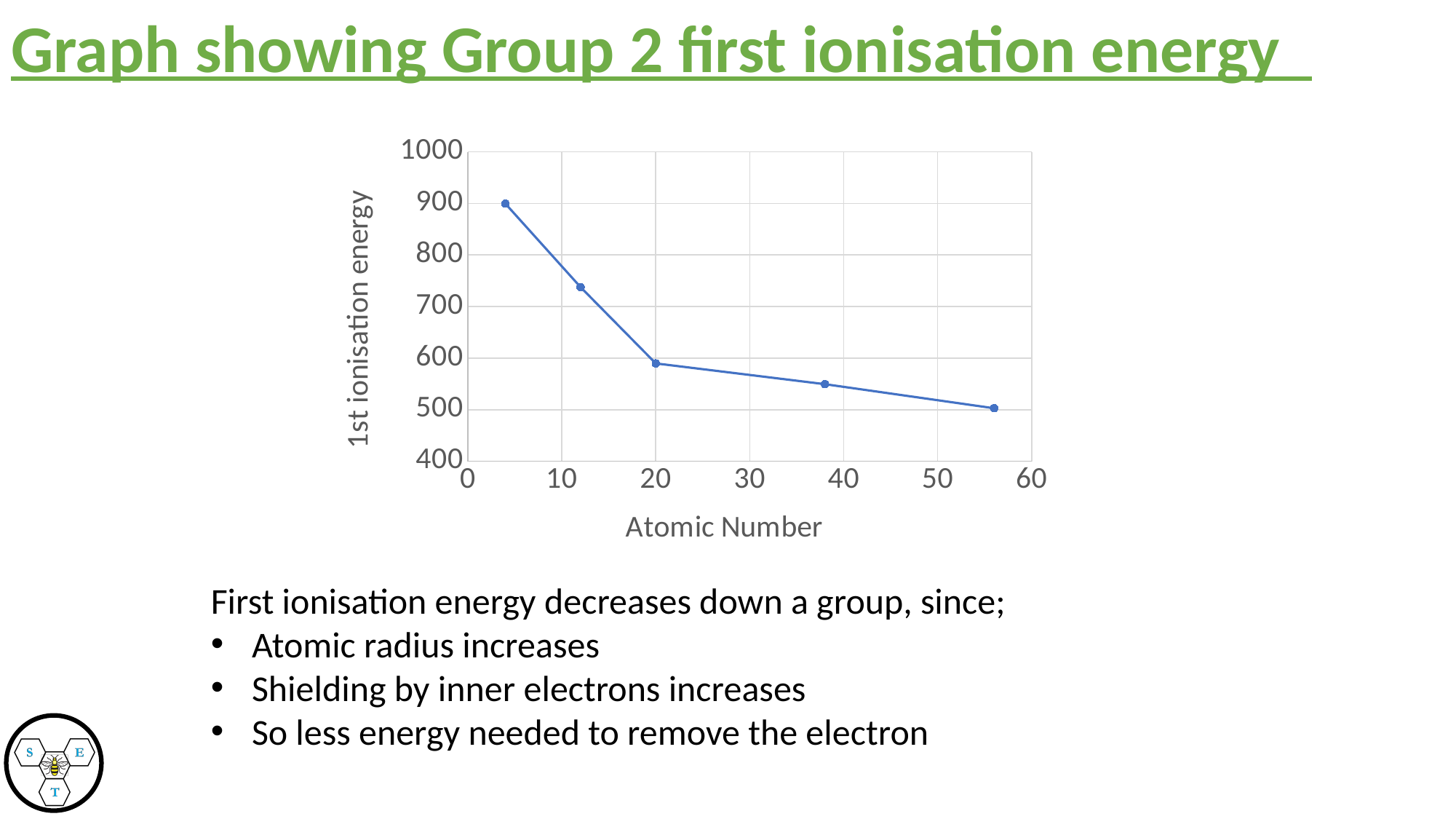
What kind of chart is shown on the slide? line chart How many data points are plotted on the chart? 5 Which plotted point has the highest first ionisation energy: the one with the lowest atomic number or the one with the highest atomic number? the one with the lowest atomic number Is the first ionisation energy of the leftmost point (lowest atomic number) greater or less than 800? greater Is the first ionisation energy of the rightmost point (highest atomic number) greater or less than 600? less What is the label on the y axis of the chart? 1st ionisation energy Does the first ionisation energy rise or fall as atomic number increases along the x axis? fall What is the label on the x axis of the chart? Atomic Number Is the first ionisation energy of the second point from the left greater or less than 700? greater Which plotted point has the lowest first ionisation energy: the leftmost point or the rightmost point? the rightmost point Which has the larger first ionisation energy: the point at atomic number 20 or the point at atomic number 40 (approximately)? the point at atomic number 20